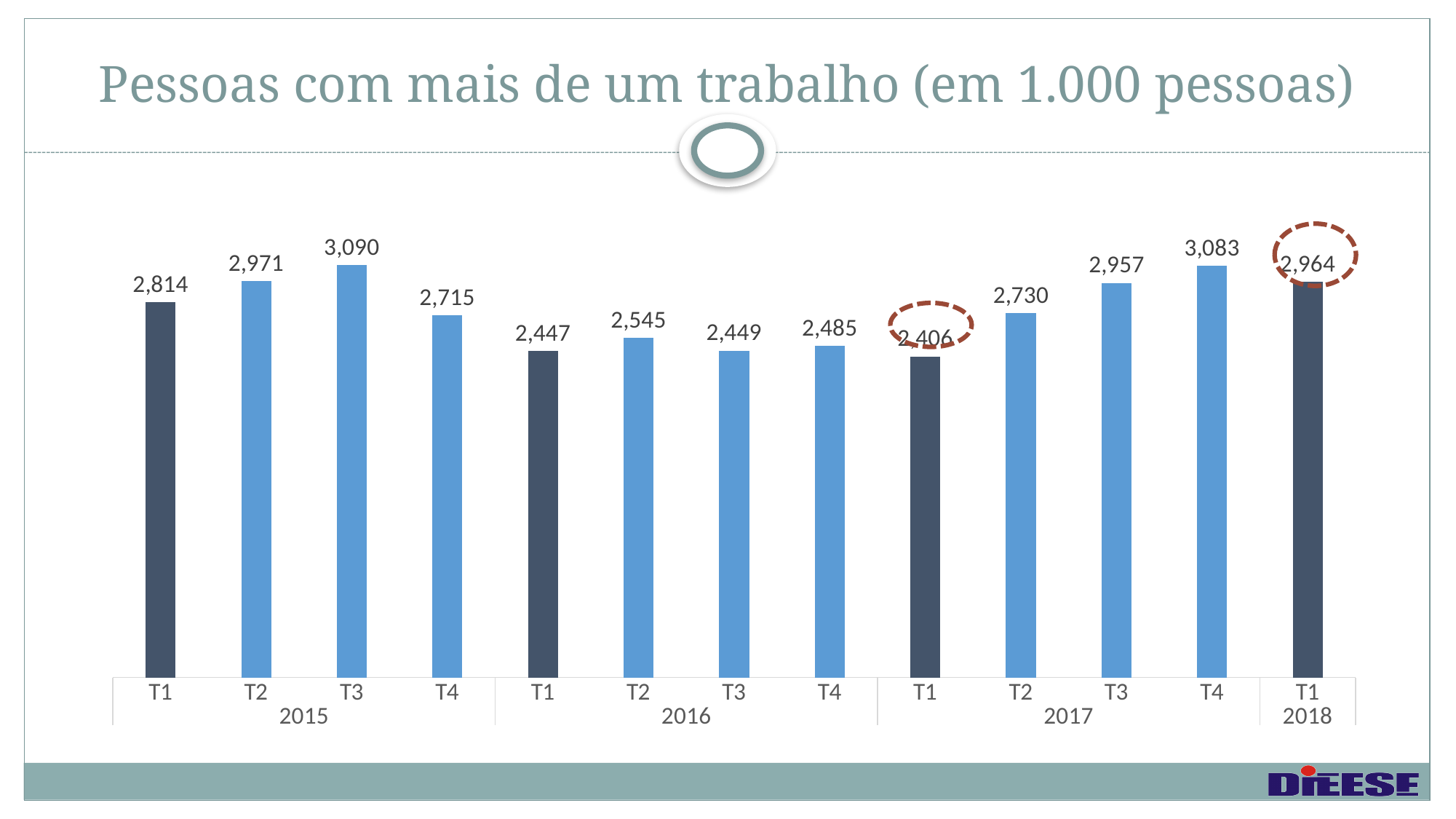
Which is larger, the value for T2 2016 or the value for T2 2017? T2 2017 Which quarter has the lowest value? T1 2017 What is the value for T1 2018? 2,964 How many bars are plotted in the chart? 13 What is the difference between T4 2017 and T1 2018? 119 What is the title of the chart? Pessoas com mais de um trabalho (em 1.000 pessoas) Which quarter has the highest value? T3 2015 What is the value for T3 2015? 3,090 What is the difference between T1 2015 and T1 2016? 367 Do the values rise or fall from T1 2017 to T4 2017? Rise What is the value for T1 2017? 2,406 What kind of chart is shown on the slide? Bar chart